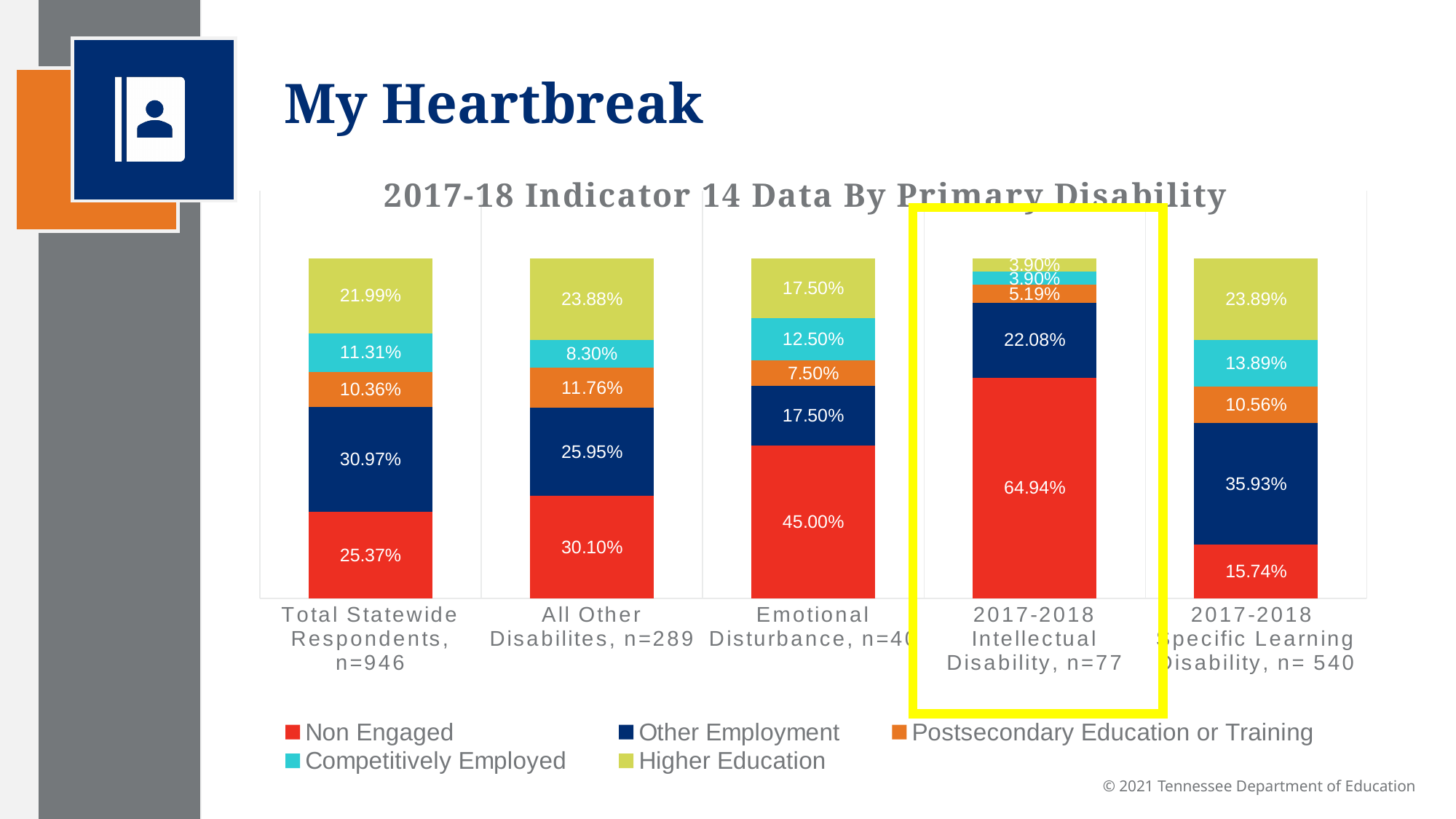
How many series does the legend list? 5 What is the title of the chart? 2017-18 Indicator 14 Data By Primary Disability What type of chart is shown on the slide? Stacked bar chart How many categories are shown along the x axis? 5 Which is larger: the Competitively Employed value for 2017-2018 Specific Learning Disability, n= 540 or for All Other Disabilites, n=289? 2017-2018 Specific Learning Disability, n= 540 What is the Higher Education value for Total Statewide Respondents, n=946? 21.99% Which category has the lowest Higher Education value? 2017-2018 Intellectual Disability, n=77 Which category has the highest Non Engaged value? 2017-2018 Intellectual Disability, n=77 What is the difference between the Non Engaged values for Emotional Disturbance and All Other Disabilites, n=289? 14.90% What is the Non Engaged value for 2017-2018 Intellectual Disability, n=77? 64.94% What is the Other Employment value for 2017-2018 Specific Learning Disability, n= 540? 35.93% Which series is shown in red in the legend? Non Engaged